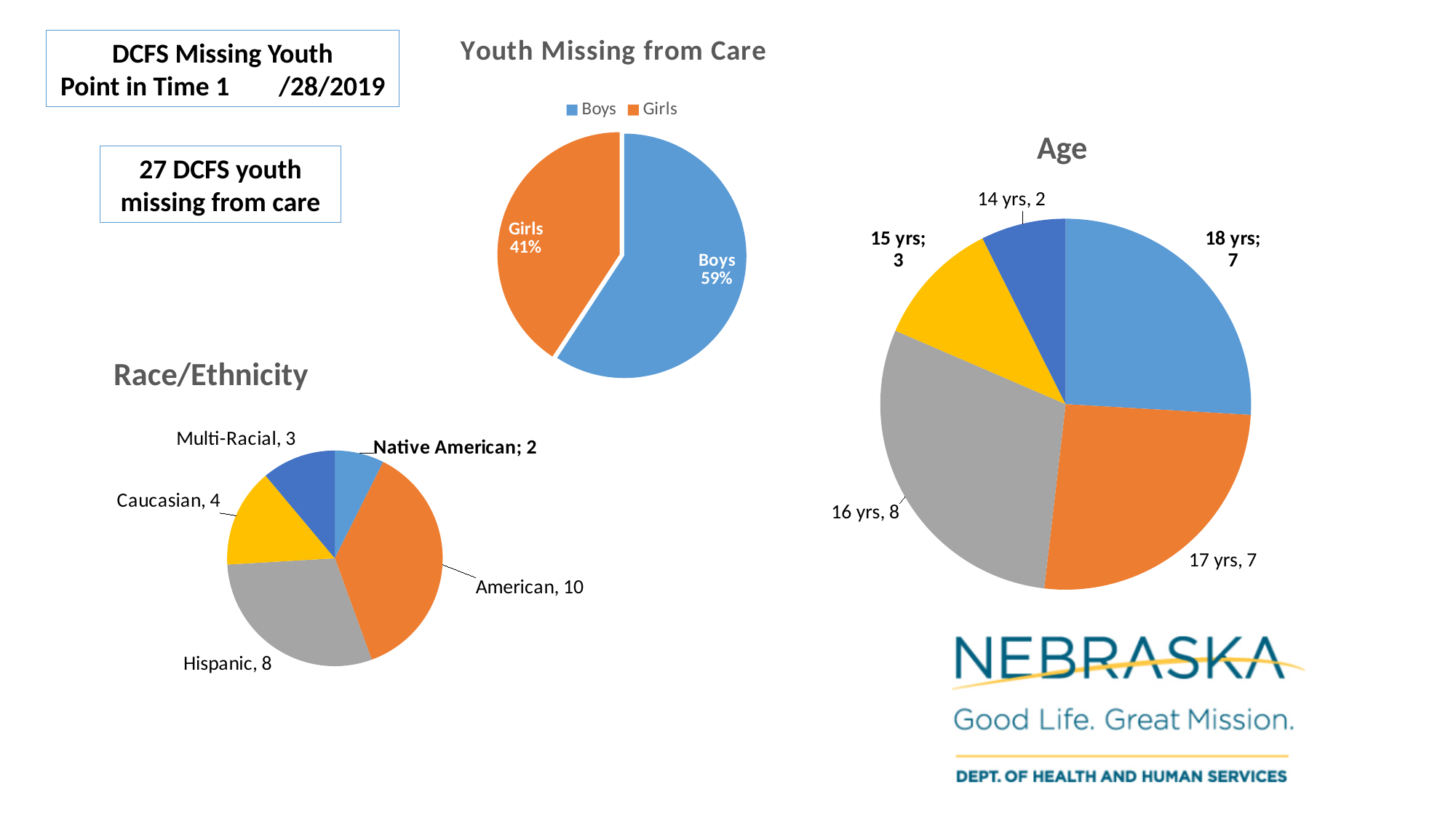
In the 'Race/Ethnicity' chart, what is the difference between the Caucasian and Multi-Racial values? 1 In the 'Age' chart, what is the difference between the values for 16 yrs and 15 yrs? 5 In the 'Race/Ethnicity' chart, which category has the lowest value? Native American What kind of chart is the 'Youth Missing from Care' chart? Pie chart In the 'Age' chart, which age group has the smallest value? 14 yrs In the 'Youth Missing from Care' chart, what percentage of youth are Boys? 59% In the 'Youth Missing from Care' chart, what percentage of youth are Girls? 41% In the 'Race/Ethnicity' chart, how many categories are shown? 5 In the 'Age' chart, what is the value for 16 yrs? 8 In the 'Youth Missing from Care' chart, which group has the larger share, Boys or Girls? Boys In the 'Race/Ethnicity' chart, what is the value for Hispanic? 8 In the 'Youth Missing from Care' chart, how many entries does the legend list? 2